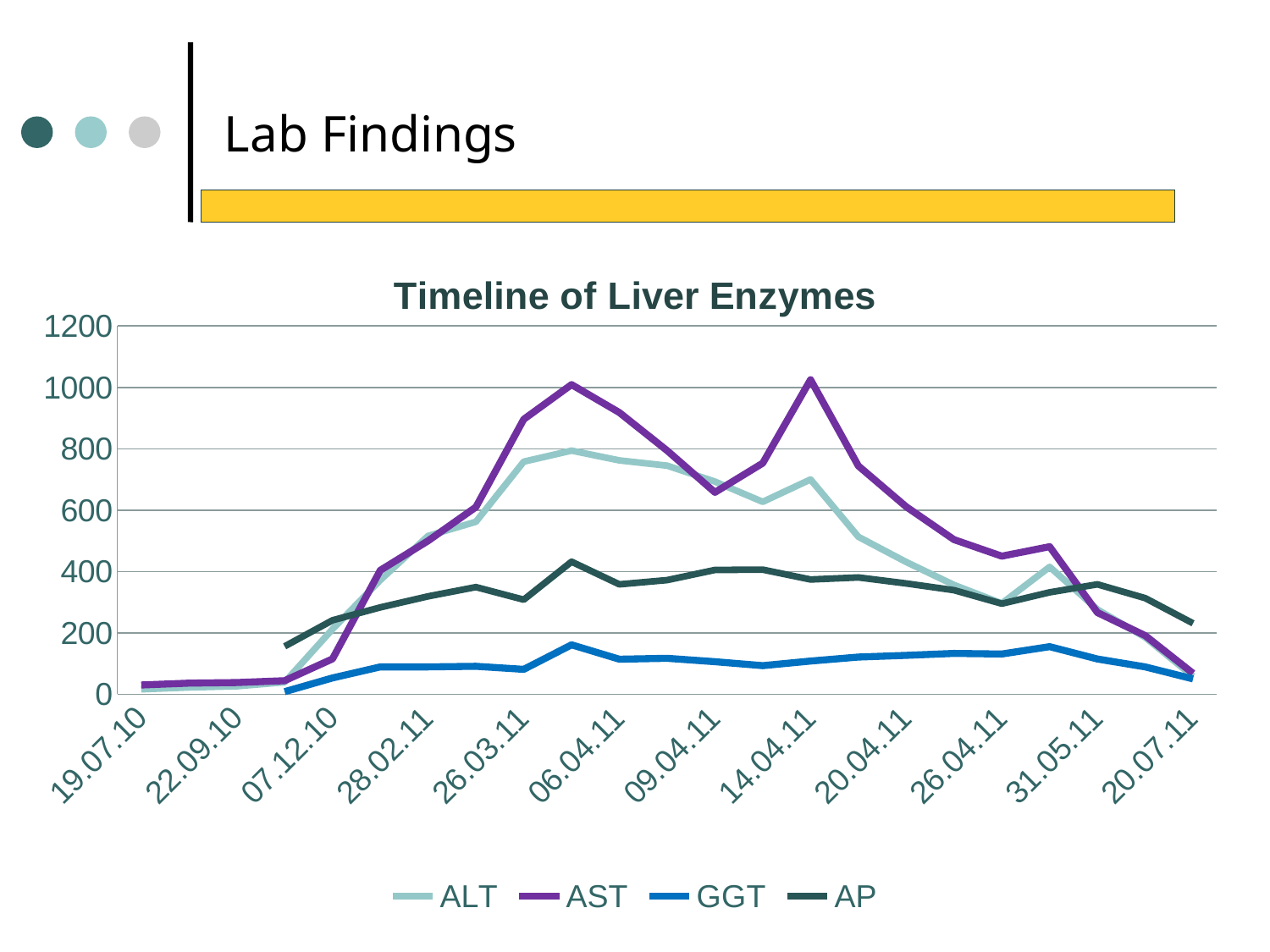
What is the title of the chart? Timeline of Liver Enzymes Which series stays lowest across the whole timeline? GGT How many series does the legend list? 4 Which series reaches the highest value on the chart? AST Is the value for GGT at 06.04.11 greater or less than 200? less Is the value for ALT at 06.04.11 greater or less than 600? greater What kind of chart is shown on the slide? line chart Does the AST line rise or fall from 19.07.10 to 06.04.11? rise Is the value for AST at 19.07.10 greater or less than 200? less Which series is drawn in purple? AST At 14.04.11, which is larger, AST or ALT? AST